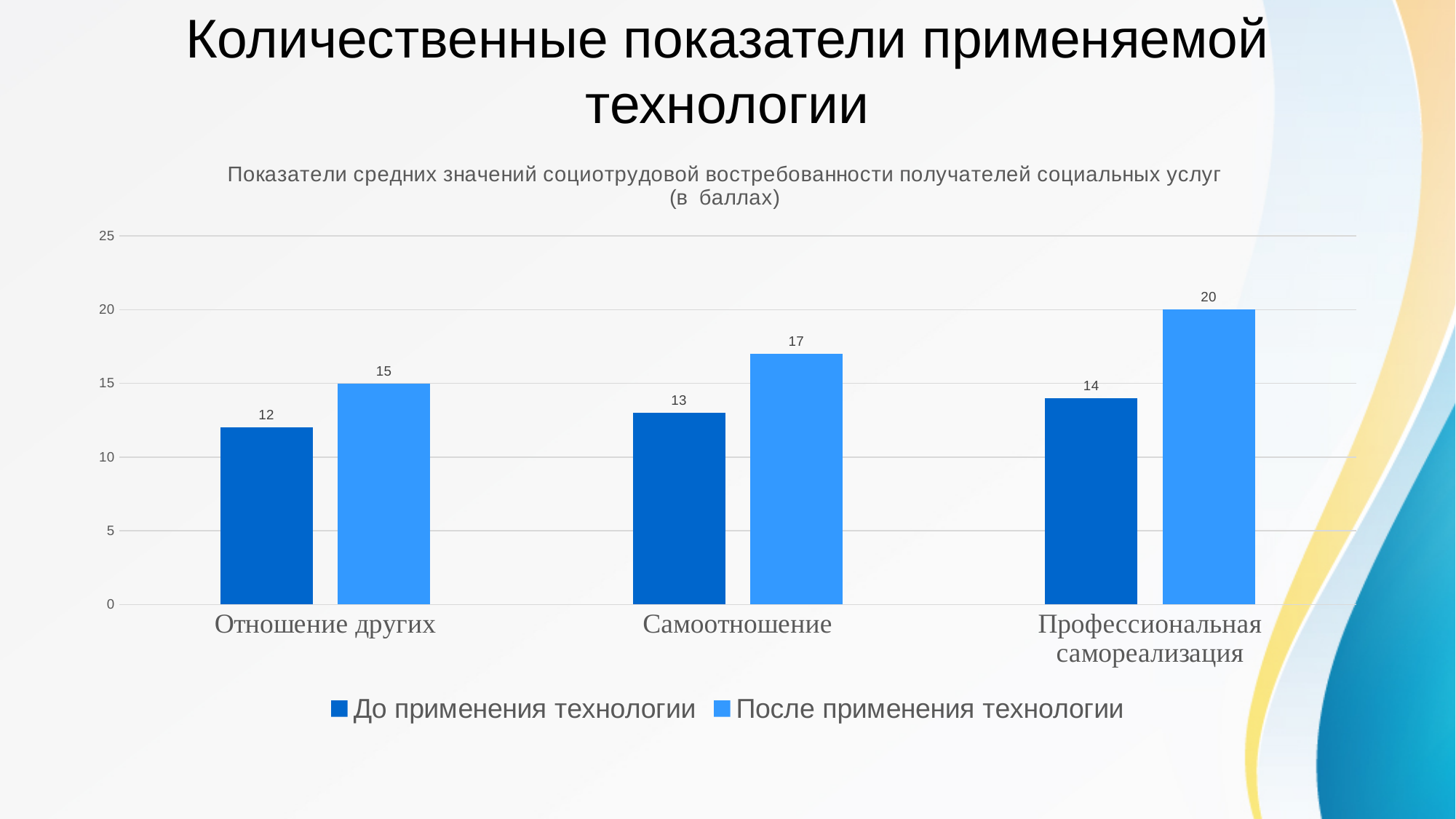
How many categories are shown on the x axis? 3 Is the 'После применения технологии' value for 'Отношение других' greater or less than 10? greater How many series does the legend list? 2 What is the title of the chart? Показатели средних значений социотрудовой востребованности получателей социальных услуг (в баллах) What is the difference between the 'После применения технологии' and 'До применения технологии' values for 'Профессиональная самореализация'? 6 Which category has the lowest value in the 'До применения технологии' series? Отношение других Which category has the highest value in the 'После применения технологии' series? Профессиональная самореализация What kind of chart is shown on the slide? bar chart What is the value for 'Отношение других' in the 'До применения технологии' series? 12 What is the value for 'Самоотношение' in the 'После применения технологии' series? 17 What is the value for 'Профессиональная самореализация' in the 'До применения технологии' series? 14 Which is larger for 'Самоотношение': the 'До применения технологии' value or the 'После применения технологии' value? После применения технологии